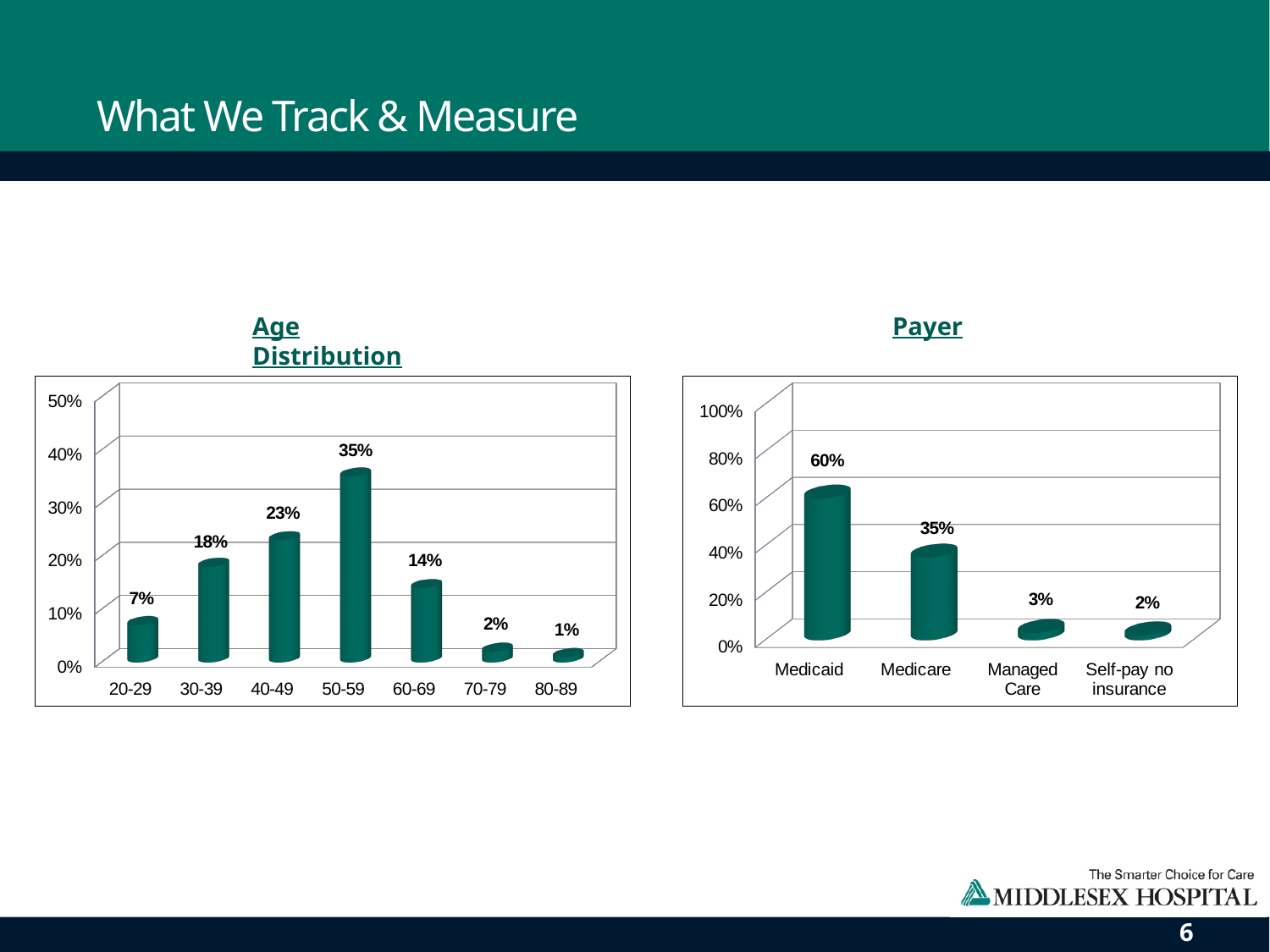
In the Age Distribution chart, which age group has the highest value? 50-59 In the Age Distribution chart, what is the difference between the values for 50-59 and 60-69? 21% In the Age Distribution chart, how many age groups are shown? 7 What kind of chart is the Payer chart? bar chart In the Age Distribution chart, do the values rise or fall from 50-59 to 80-89? fall In the Age Distribution chart, what is the value for the 40-49 age group? 23% In the Payer chart, what is the difference between the values for Medicaid and Medicare? 25% In the Payer chart, which payer has the highest value? Medicaid In the Payer chart, how many payer categories are shown? 4 In the Payer chart, what is the value for Medicare? 35% In the Age Distribution chart, which age group has the lowest value? 80-89 In the Payer chart, which is larger, the value for Managed Care or the value for Self-pay no insurance? Managed Care